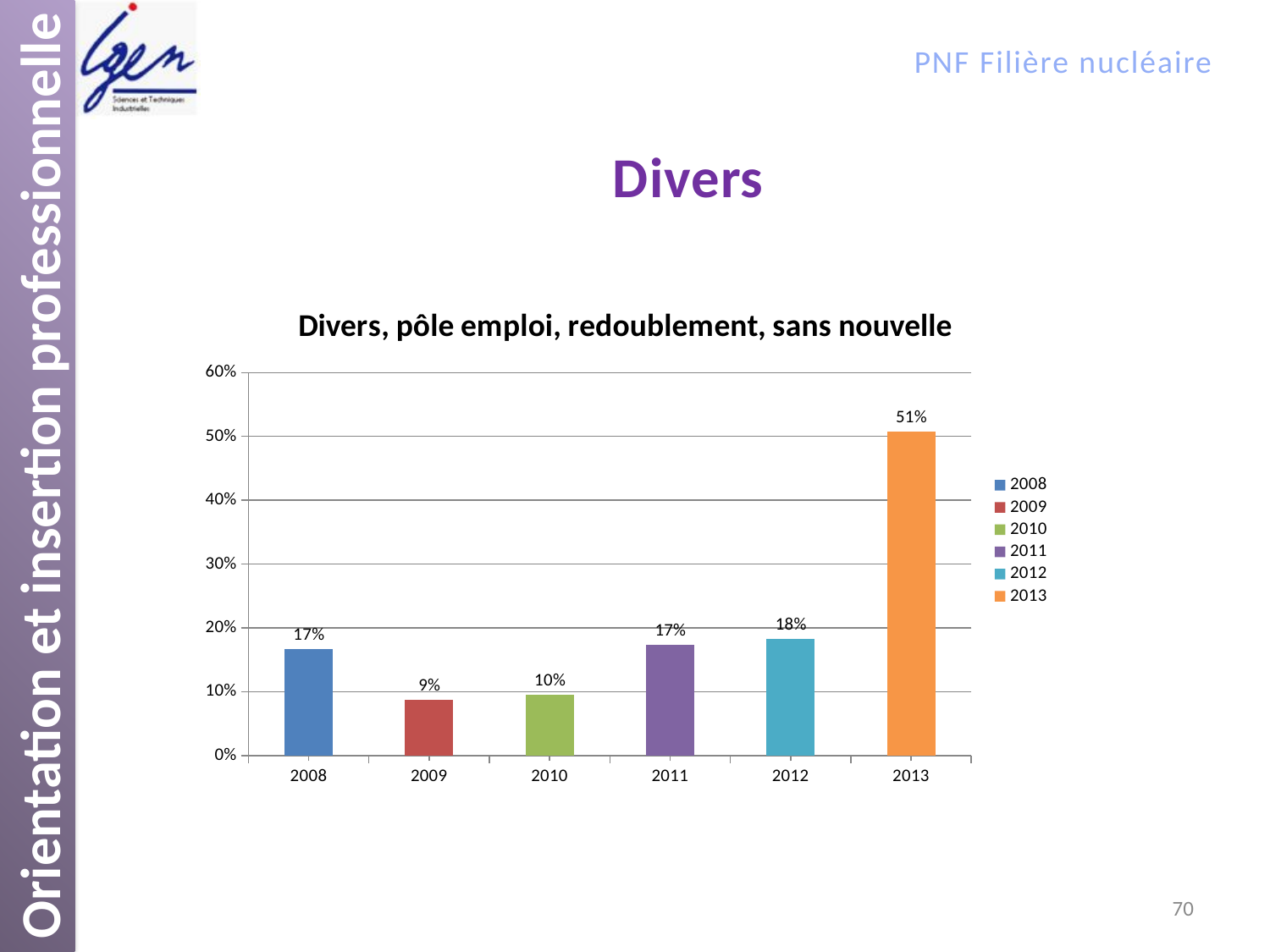
What is the value for 2012? 18% What is the difference between the values for 2013 and 2012? 33% What kind of chart is shown? bar chart What is the value for 2009? 9% Which is larger, the value for 2010 or the value for 2012? 2012 What is the title of the chart? Divers, pôle emploi, redoublement, sans nouvelle Is the value for 2013 greater or less than 50%? greater How many entries does the legend list? 6 How many years are shown on the x axis? 6 Which year has the highest value? 2013 Which year has the lowest value? 2009 What is the value for 2013? 51%